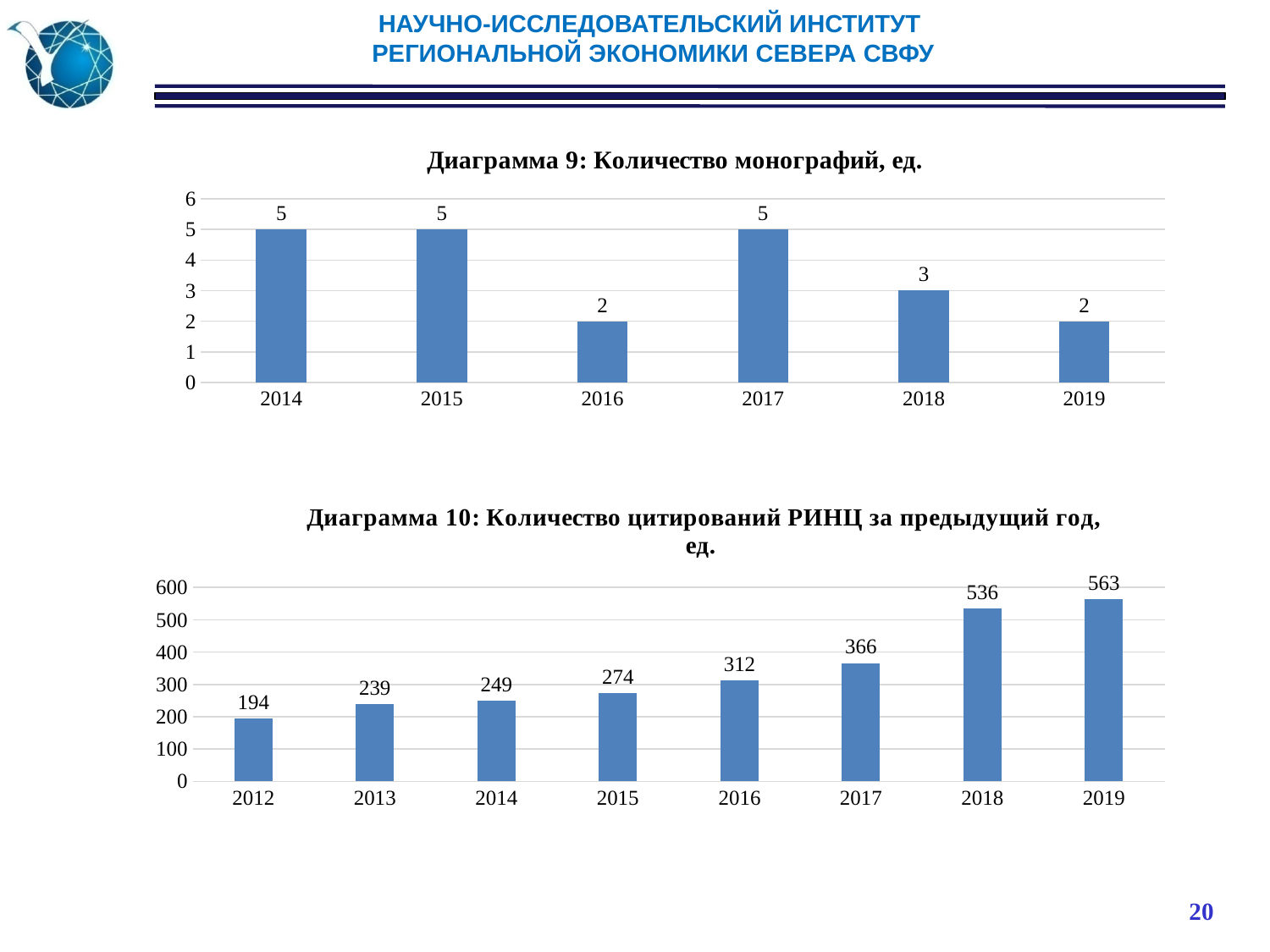
In the chart 'Диаграмма 10: Количество цитирований РИНЦ за предыдущий год, ед.', which year has the lowest value? 2012 In the chart 'Диаграмма 10: Количество цитирований РИНЦ за предыдущий год, ед.', what is the value for 2015? 274 In the chart 'Диаграмма 9: Количество монографий, ед.', what is the value for 2018? 3 In the chart 'Диаграмма 10: Количество цитирований РИНЦ за предыдущий год, ед.', which year has the highest value? 2019 In the chart 'Диаграмма 10: Количество цитирований РИНЦ за предыдущий год, ед.', what is the difference between the values for 2018 and 2017? 170 In the chart 'Диаграмма 9: Количество монографий, ед.', what is the value for 2016? 2 In the chart 'Диаграмма 9: Количество монографий, ед.', how many years are shown on the x axis? 6 In the chart 'Диаграмма 9: Количество монографий, ед.', what is the difference between the values for 2017 and 2018? 2 In the chart 'Диаграмма 10: Количество цитирований РИНЦ за предыдущий год, ед.', how many years are shown on the x axis? 8 In the chart 'Диаграмма 10: Количество цитирований РИНЦ за предыдущий год, ед.', do the values rise or fall from 2012 to 2019? Rise What kind of chart is 'Диаграмма 10: Количество цитирований РИНЦ за предыдущий год, ед.'? Bar chart In the chart 'Диаграмма 9: Количество монографий, ед.', which year has the lowest value, 2018 or 2019? 2019